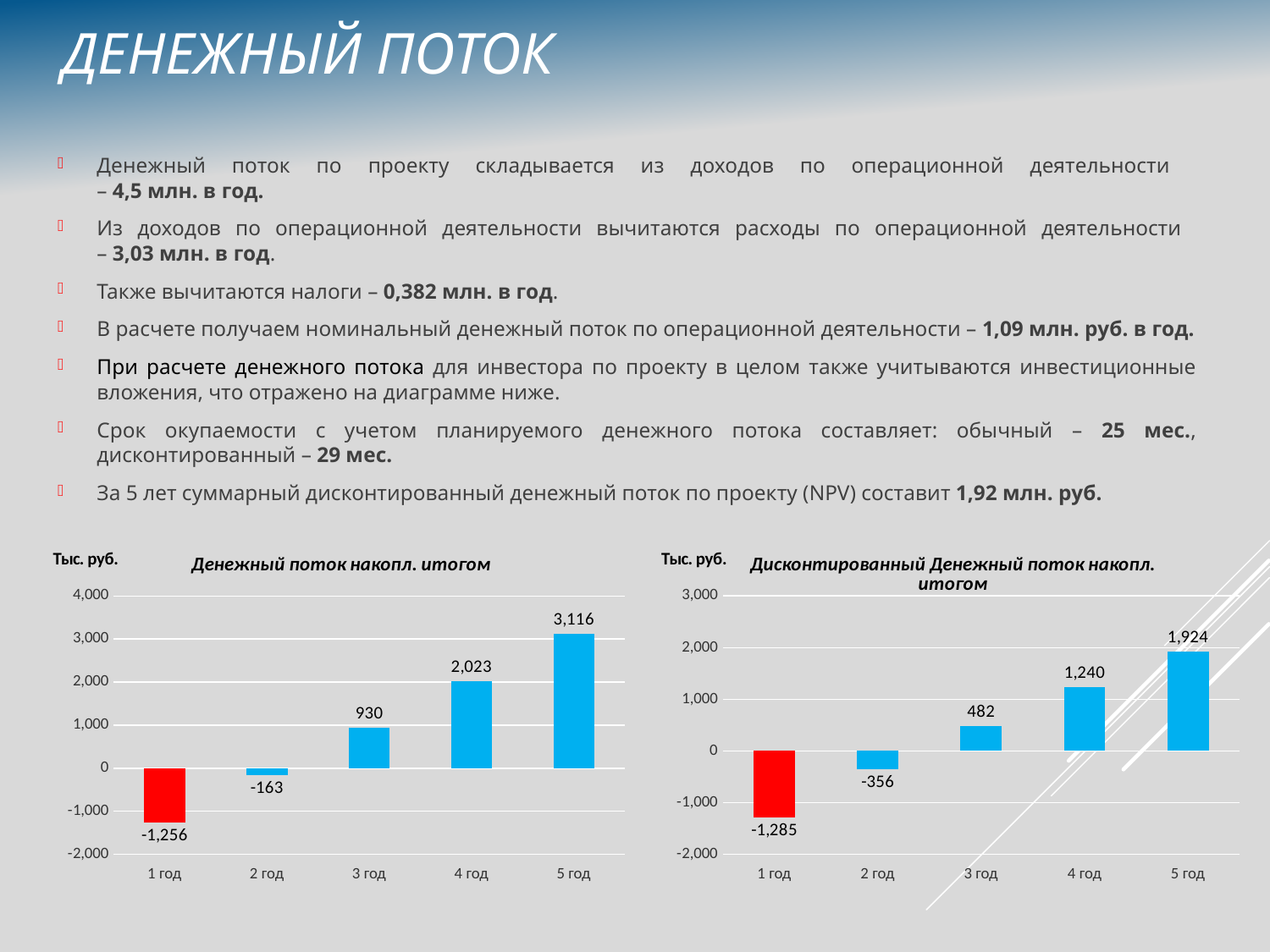
In the right chart, which year has the highest value? 5 год What kind of chart is the chart titled "Дисконтированный Денежный поток накопл. итогом"? bar chart In the right chart, what colour is the bar for 1 год? red In the right chart, what is the difference between the values for 4 год and 3 год? 758 In the left chart, which is larger: the value for 2 год or the value for 3 год? 3 год In the left chart, which year has the lowest value? 1 год In the chart titled "Дисконтированный Денежный поток накопл. итогом", what is the value for 5 год? 1,924 In the left chart, what is the difference between the values for 5 год and 4 год? 1,093 In the right chart, is the value for 4 год greater or less than 1,000? greater How many categories are shown on the x axis of the left chart? 5 In the left chart, do the values rise or fall from 1 год to 5 год? rise In the chart titled "Денежный поток накопл. итогом", what is the value for 3 год? 930